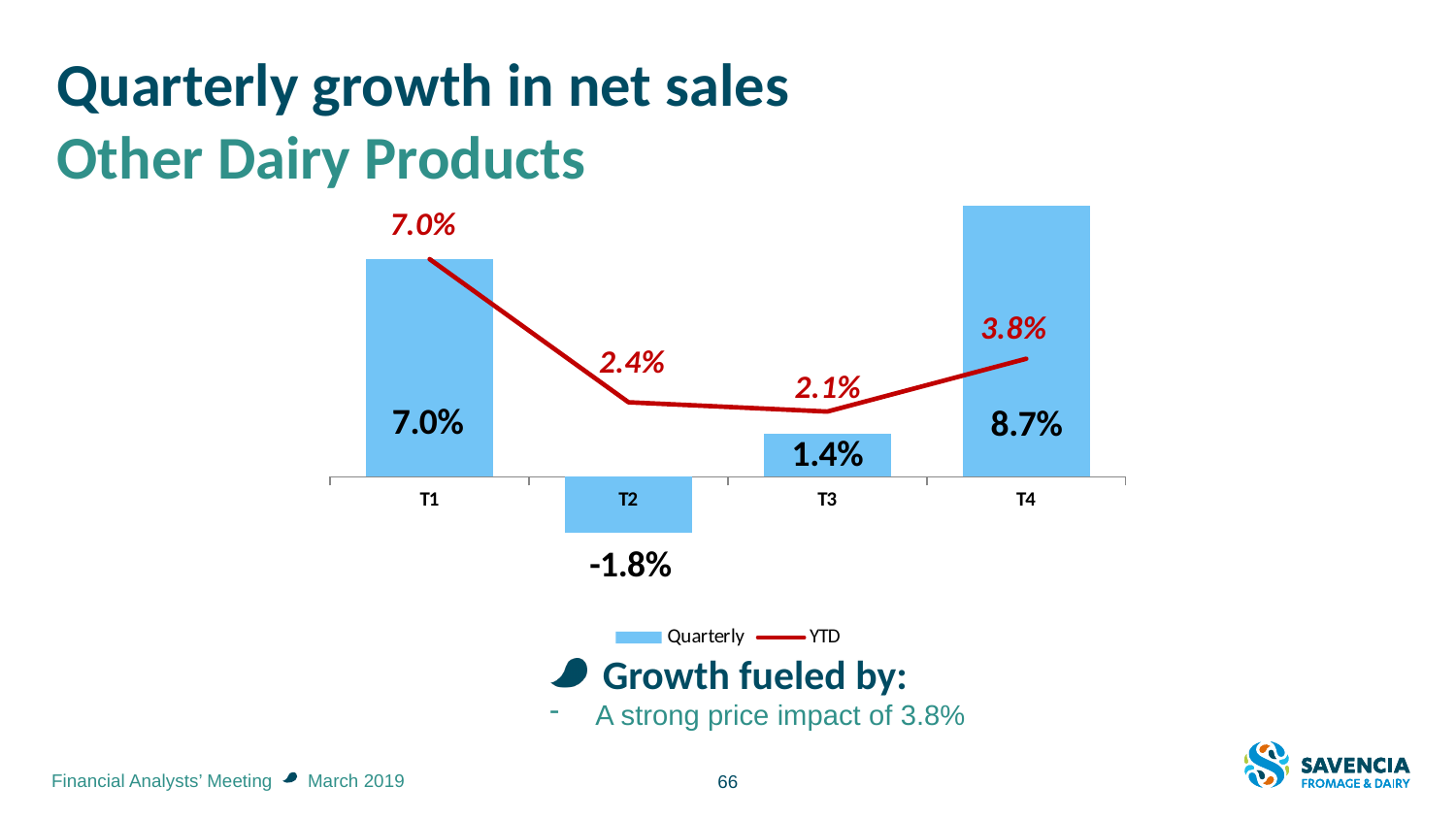
How many quarters are shown on the x axis? 4 Which series is drawn as a red line? YTD What is the Quarterly growth value for T4? 8.7% Which is larger, the YTD value for T2 or the YTD value for T3? T2 Which quarter has the highest Quarterly growth? T4 What is the YTD value for T4? 3.8% What is the YTD value for T3? 2.1% How many series does the legend list? 2 Which quarter has the lowest Quarterly growth? T2 What is the difference between the Quarterly values for T4 and T1? 1.7% Does the YTD line rise or fall from T1 to T3? fall What is the Quarterly growth value for T2? -1.8%